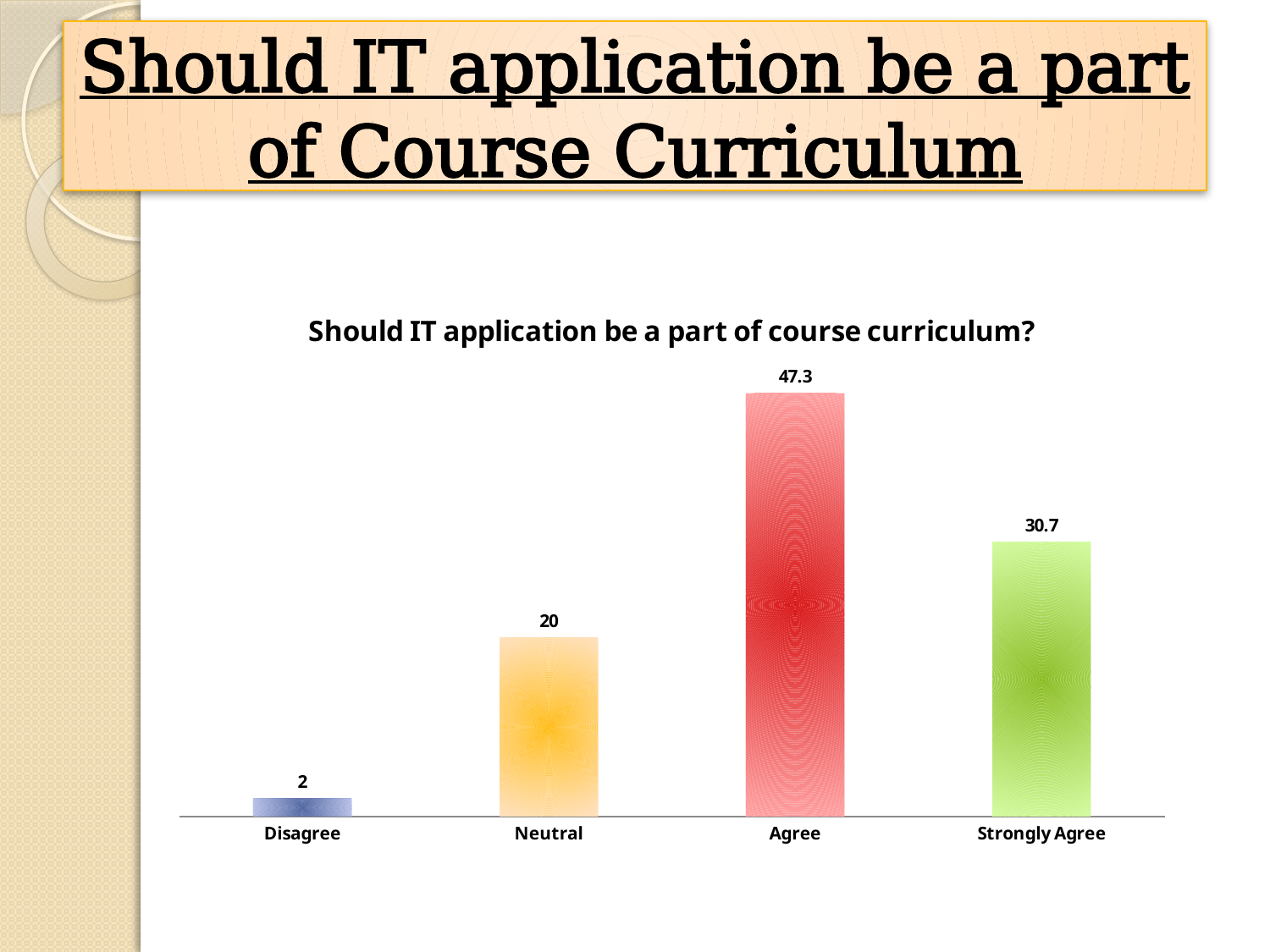
How many categories are shown on the x axis? 4 What is the value for Strongly Agree? 30.7 Which is larger, the value for Neutral or the value for Strongly Agree? Strongly Agree What is the title of the chart? Should IT application be a part of course curriculum? What is the difference between the values for Neutral and Disagree? 18 What kind of chart is shown on the slide? Bar chart What is the value for Agree? 47.3 What is the value for Disagree? 2 Which category has the highest value? Agree Which category has the lowest value? Disagree What is the value for Neutral? 20 What is the difference between the values for Agree and Strongly Agree? 16.6